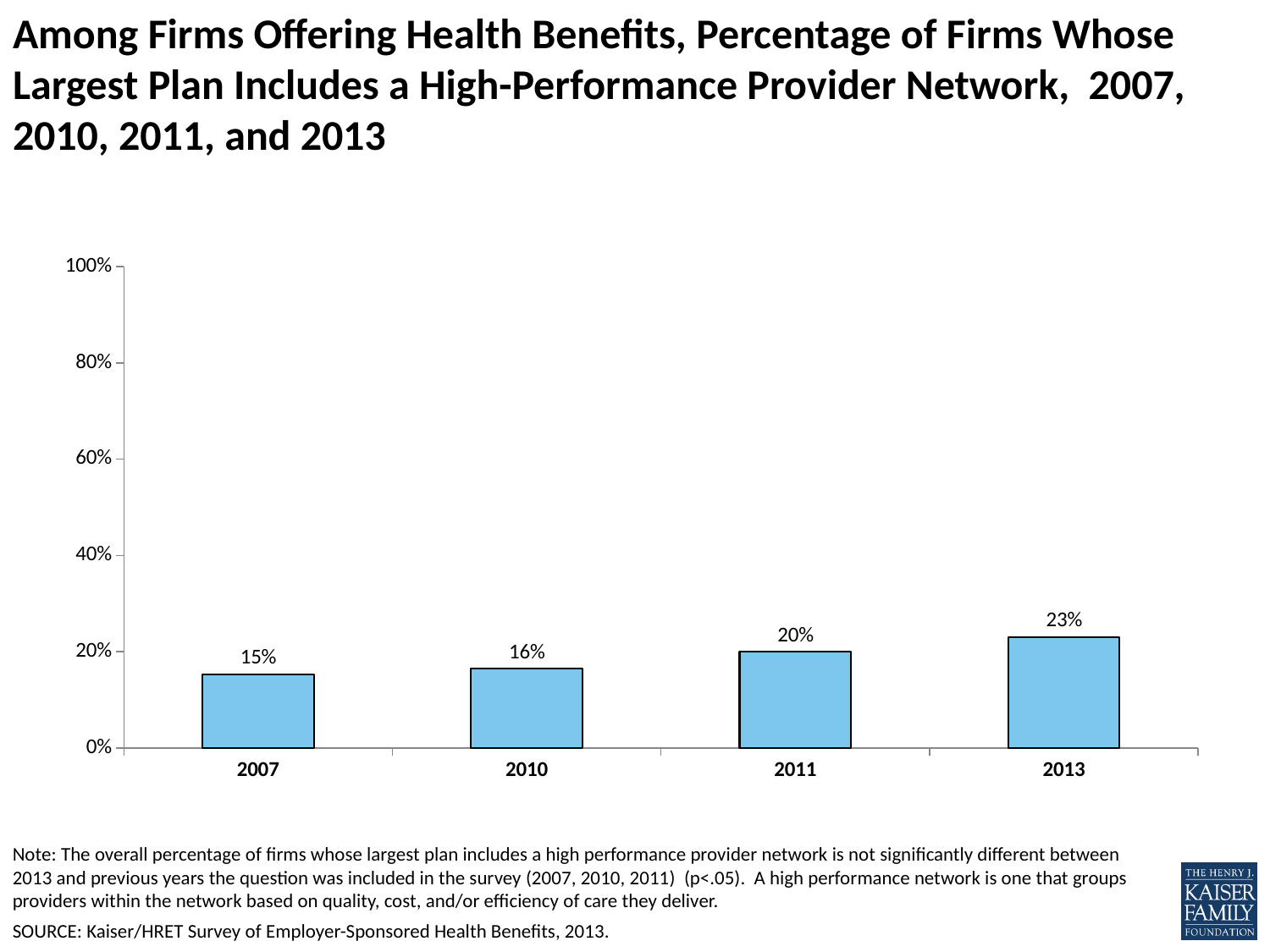
How many years are shown on the x axis? 4 What is the difference in percentage points between 2013 and 2007? 8 percentage points Which is larger, the value for 2011 or the value for 2010? 2011 What is the value shown for 2013? 23% What is the value shown for 2011? 20% What is the value shown for 2010? 16% Which year has the highest percentage? 2013 What kind of chart is shown on the slide? Bar chart What percentage of firms had a largest plan including a high-performance provider network in 2007? 15% Do the values rise or fall from 2007 to 2013? Rise Which year has the lowest percentage? 2007 Is the value for 2013 greater or less than 40%? less